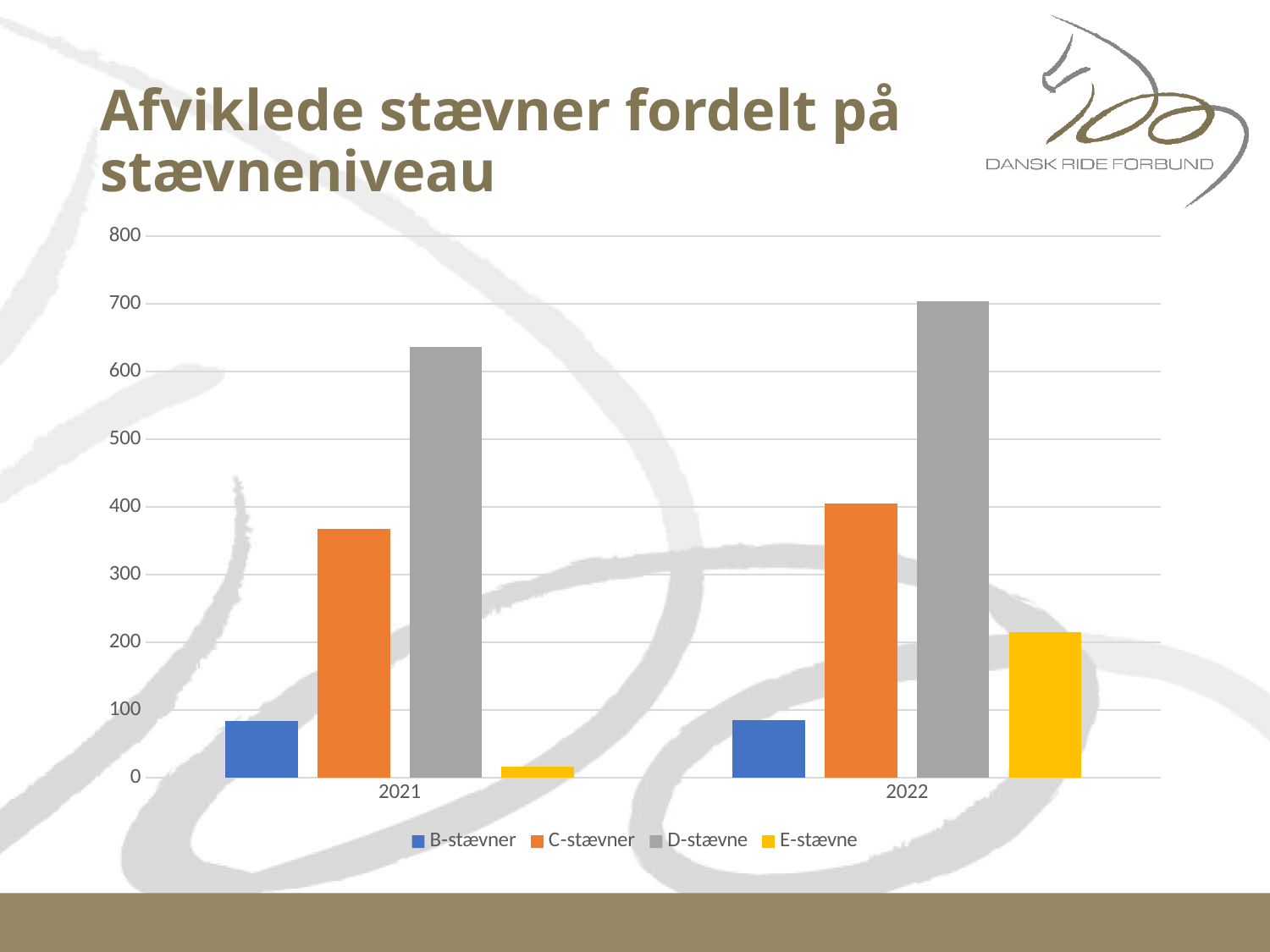
What kind of chart is shown on the slide? bar chart What colour are the bars for C-stævner? orange Is the value for B-stævner in 2022 greater or less than 100? less How many series does the legend list? 4 Is the value for D-stævne in 2021 greater or less than 600? greater Which series has the highest value in 2022? D-stævne How many years are shown on the x axis? 2 Which series has the lowest value in 2021? E-stævne Which is larger, C-stævner in 2021 or C-stævner in 2022? C-stævner in 2022 Is the value for E-stævne in 2022 greater or less than 200? greater Which is larger, E-stævne in 2021 or E-stævne in 2022? E-stævne in 2022 Does the value for D-stævne rise or fall from 2021 to 2022? rise